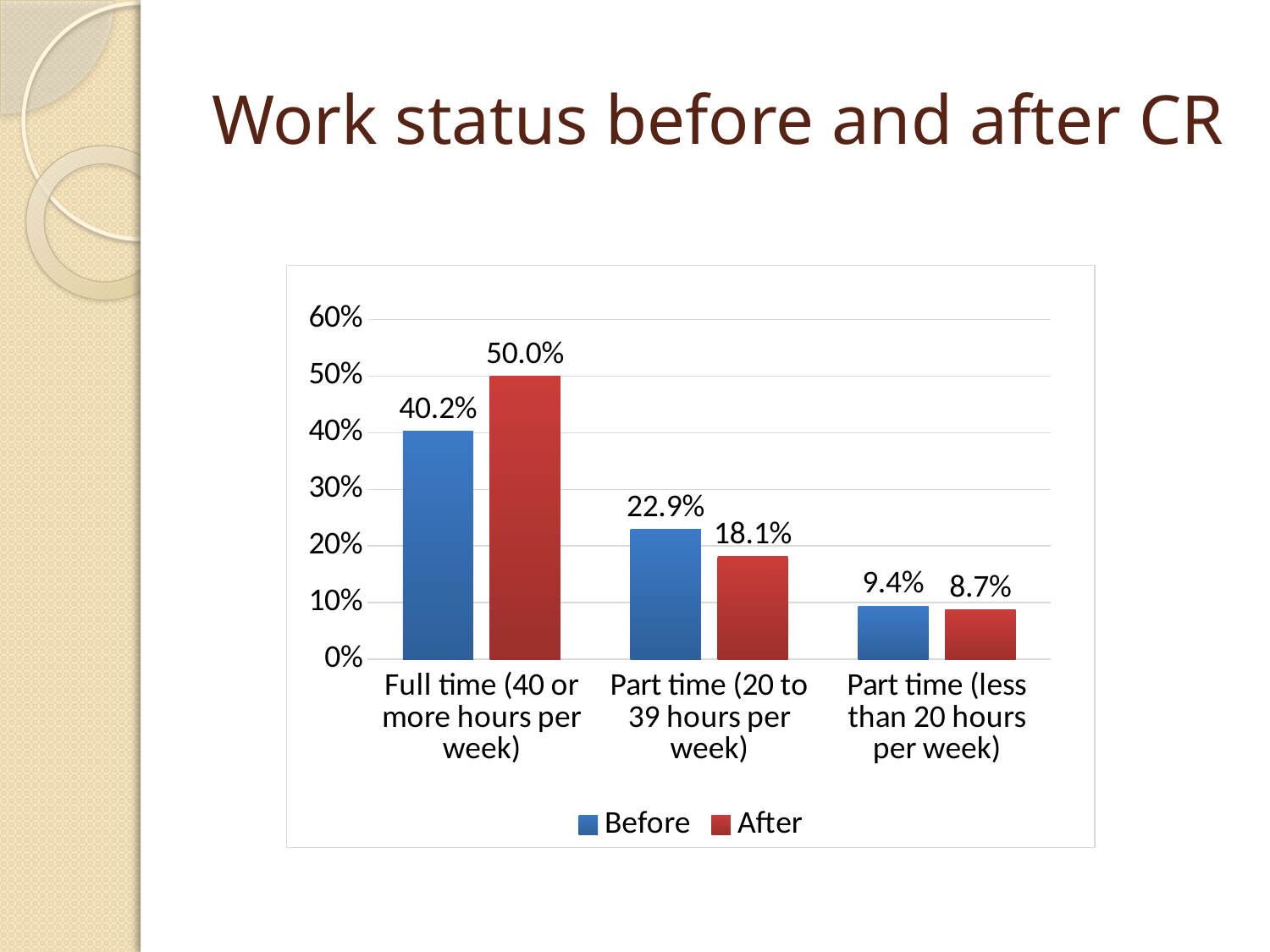
What is the Before value for Full time (40 or more hours per week)? 40.2% Which category has the lowest Before value? Part time (less than 20 hours per week) Which category has the highest After value? Full time (40 or more hours per week) What kind of chart is shown on the slide? Bar chart What colour are the After bars? Red Which is larger for Part time (20 to 39 hours per week): the Before value or the After value? Before How many series does the legend list? 2 What is the After value for Part time (less than 20 hours per week)? 8.7% How many categories are shown on the x axis? 3 What is the After value for Part time (20 to 39 hours per week)? 18.1% Is the Before value for Part time (20 to 39 hours per week) greater or less than 20%? greater What is the difference between the After and Before values for Full time (40 or more hours per week)? 9.8%